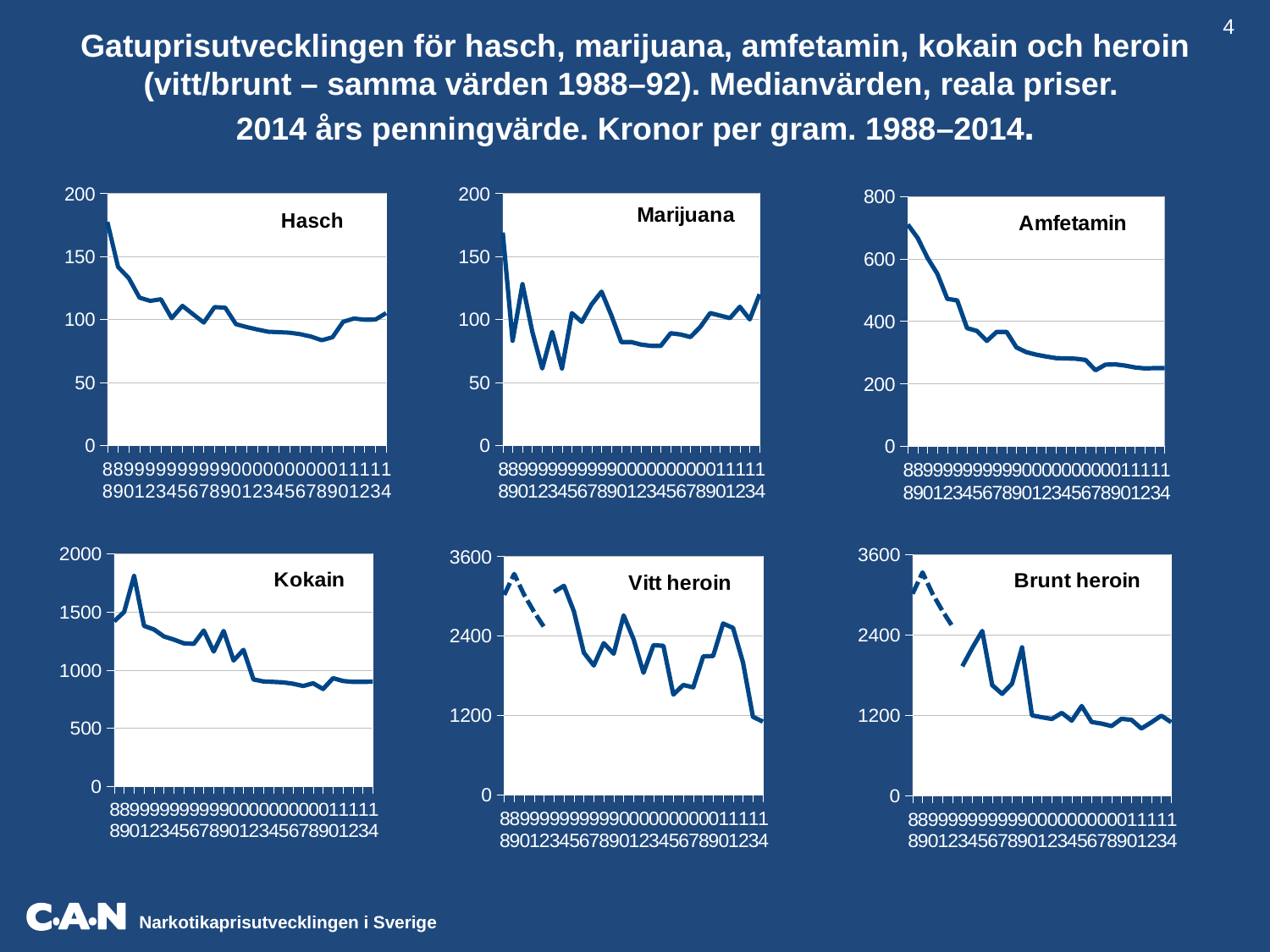
In the Amfetamin chart, which is larger, the value for 1988 or the value for 2014? 1988 In the Amfetamin chart, which year has the highest value? 1988 What is the highest value shown on the y axis of the Kokain chart? 2000 What kind of chart is the Hasch chart? line chart In the Amfetamin chart, is the value for 2014 greater or less than 400? less In the Amfetamin chart, do the values generally rise or fall over the period? fall How many charts are shown on the slide? 6 In the Brunt heroin chart, is the value for 2014 greater or less than 2400? less In the Hasch chart, do the values generally rise or fall from 1988 to 2014? fall In the Kokain chart, is the value for 2014 greater or less than 1000? less